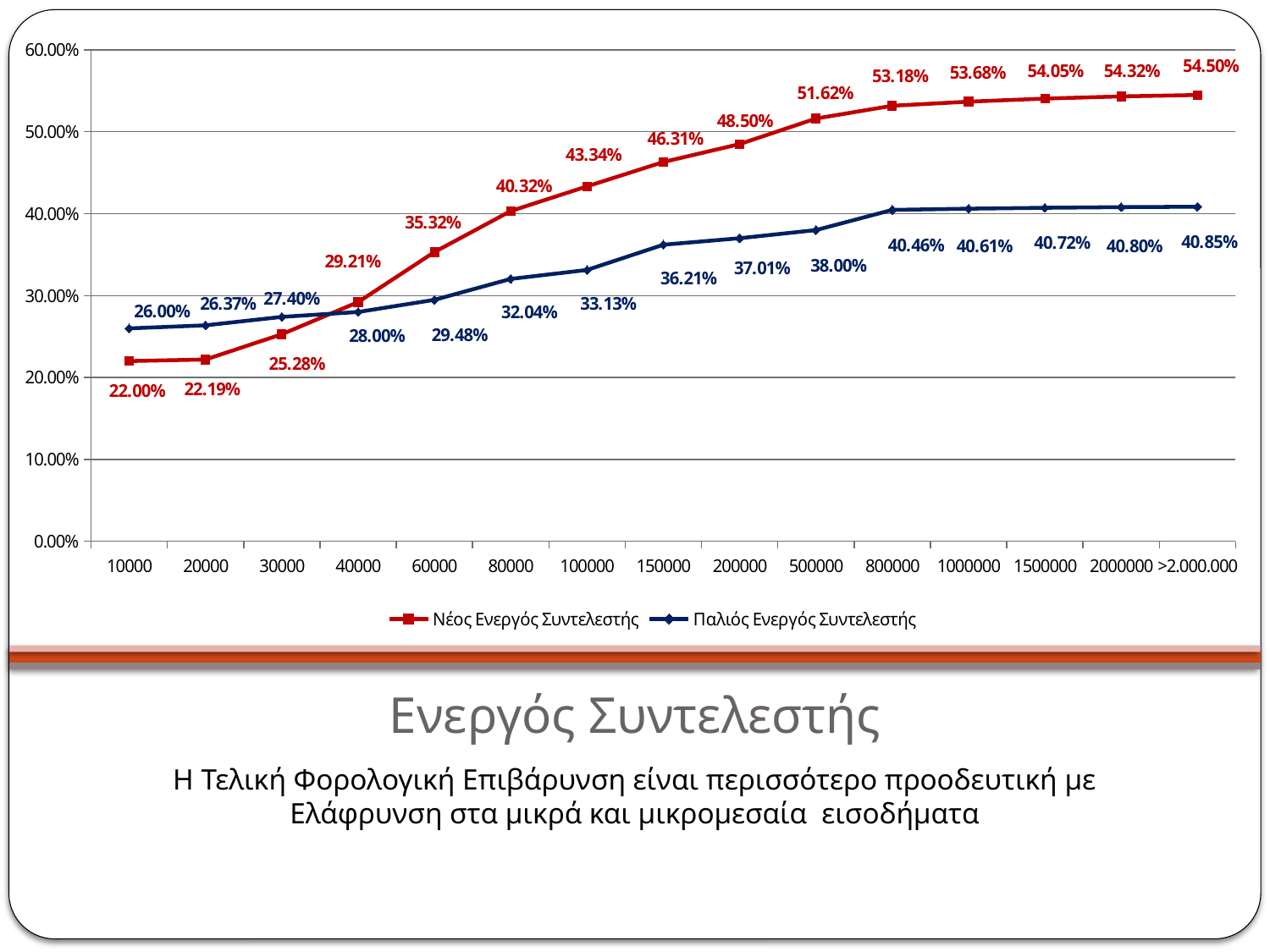
Does the Νέος Ενεργός Συντελεστής series rise or fall as income increases along the x axis? Rise What is the value of Παλιός Ενεργός Συντελεστής at 150000? 36.21% At 20000, which series has the larger value, Νέος Ενεργός Συντελεστής or Παλιός Ενεργός Συντελεστής? Παλιός Ενεργός Συντελεστής What is the value of Νέος Ενεργός Συντελεστής at >2.000.000? 54.50% What is the value of Νέος Ενεργός Συντελεστής at 100000? 43.34% What is the difference between Νέος Ενεργός Συντελεστής and Παλιός Ενεργός Συντελεστής at 500000? 13.62% At which income category is Νέος Ενεργός Συντελεστής highest? >2.000.000 At which income category is Παλιός Ενεργός Συντελεστής lowest? 10000 How many series does the legend list? 2 Which colour is used for the Νέος Ενεργός Συντελεστής line? Red What type of chart is shown on the slide? Line chart How many income categories are shown on the x axis? 15